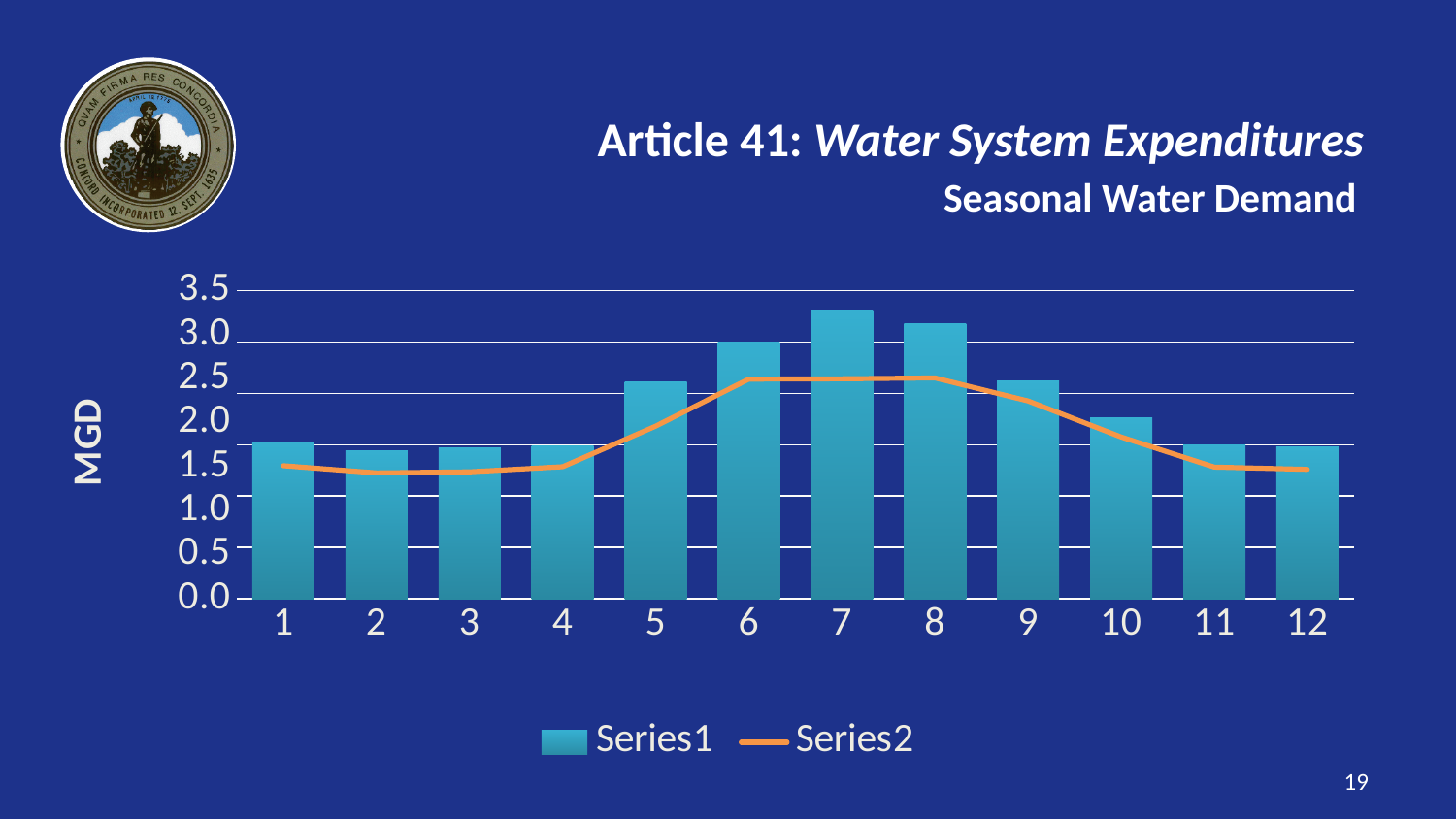
Is the Series1 value for category 1 greater or less than 2.0? less Is the Series2 value for category 7 greater or less than 2.0? greater Do the Series1 bars rise or fall from category 1 to category 7? rise Is the Series1 value for category 5 greater or less than 2.0? greater Which category has the highest Series1 bar? 7 How many series does the chart's legend list? 2 What label is shown on the chart's vertical axis? MGD How many categories are shown on the x axis of the chart? 12 Which series is drawn as a line in the chart? Series2 Which has the larger Series1 value, category 6 or category 3? 6